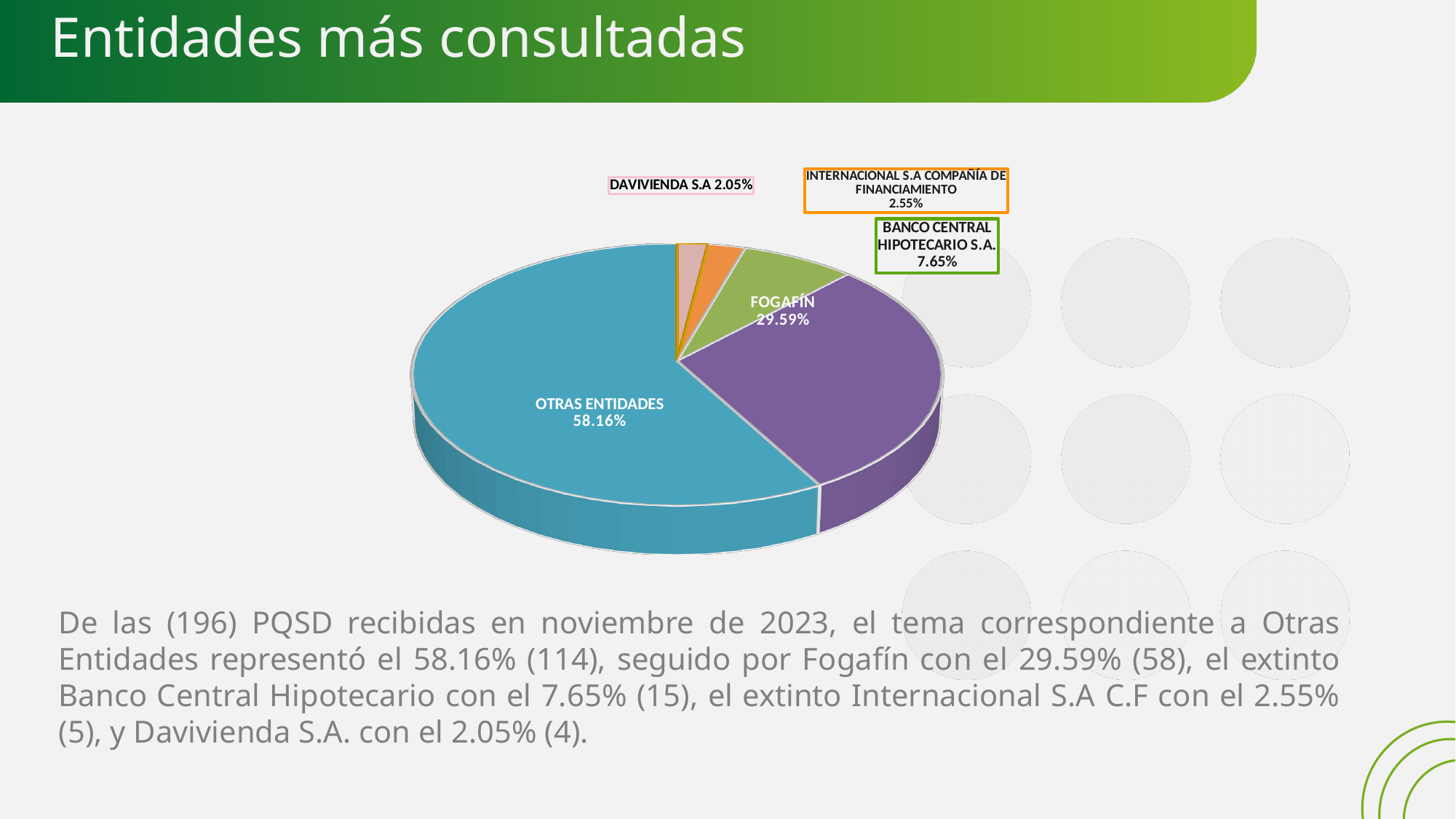
What kind of chart is shown on the slide? Pie chart What colour is the OTRAS ENTIDADES slice? Blue What share of the pie does OTRAS ENTIDADES represent? 58.16% What is the value shown for INTERNACIONAL S.A COMPAÑÍA DE FINANCIAMIENTO? 2.55% What is the value shown for BANCO CENTRAL HIPOTECARIO S.A.? 7.65% How many categories are shown in the pie chart? 5 Which category has the smallest slice of the pie? DAVIVIENDA S.A What is the difference between the shares of OTRAS ENTIDADES and FOGAFÍN? 28.57% Which is larger, the share for BANCO CENTRAL HIPOTECARIO S.A. or the share for INTERNACIONAL S.A COMPAÑÍA DE FINANCIAMIENTO? BANCO CENTRAL HIPOTECARIO S.A. Which category has the largest slice of the pie? OTRAS ENTIDADES What is the value shown for DAVIVIENDA S.A? 2.05% What is the value shown for FOGAFÍN? 29.59%